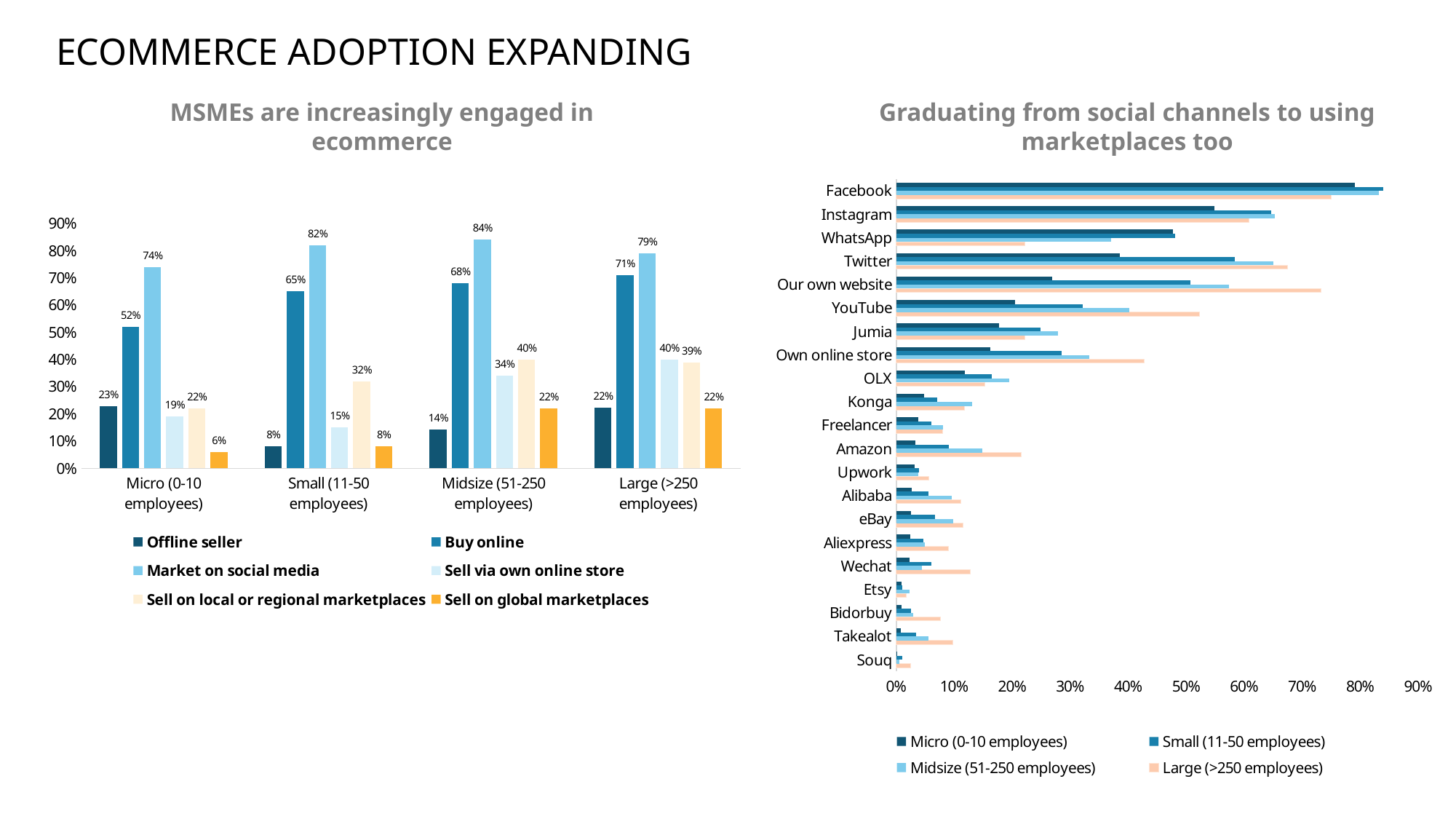
In the chart 'Graduating from social channels to using marketplaces too', is the value for WhatsApp for Large (>250 employees) greater or less than 30%? less In the chart 'MSMEs are increasingly engaged in ecommerce', what is the value for 'Market on social media' for Midsize (51-250 employees)? 84% How many channels are listed on the vertical axis of the chart 'Graduating from social channels to using marketplaces too'? 21 In the chart 'Graduating from social channels to using marketplaces too', is the value for Facebook for Micro (0-10 employees) greater or less than 70%? greater In the chart 'MSMEs are increasingly engaged in ecommerce', what is the value for 'Sell on global marketplaces' for Small (11-50 employees)? 8% What kind of chart is 'Graduating from social channels to using marketplaces too'? Bar chart How many series does the legend of the chart 'MSMEs are increasingly engaged in ecommerce' list? 6 In the chart 'MSMEs are increasingly engaged in ecommerce', which is larger for Large (>250 employees): 'Sell via own online store' or 'Sell on local or regional marketplaces'? Sell via own online store In the chart 'MSMEs are increasingly engaged in ecommerce', what is the difference between 'Market on social media' and 'Buy online' for Small (11-50 employees)? 17% In the chart 'MSMEs are increasingly engaged in ecommerce', which size category has the lowest value for 'Sell via own online store'? Small (11-50 employees) In the chart 'MSMEs are increasingly engaged in ecommerce', which size category has the highest value for 'Buy online'? Large (>250 employees) In the chart 'MSMEs are increasingly engaged in ecommerce', what is the value for 'Offline seller' for Micro (0-10 employees)? 23%